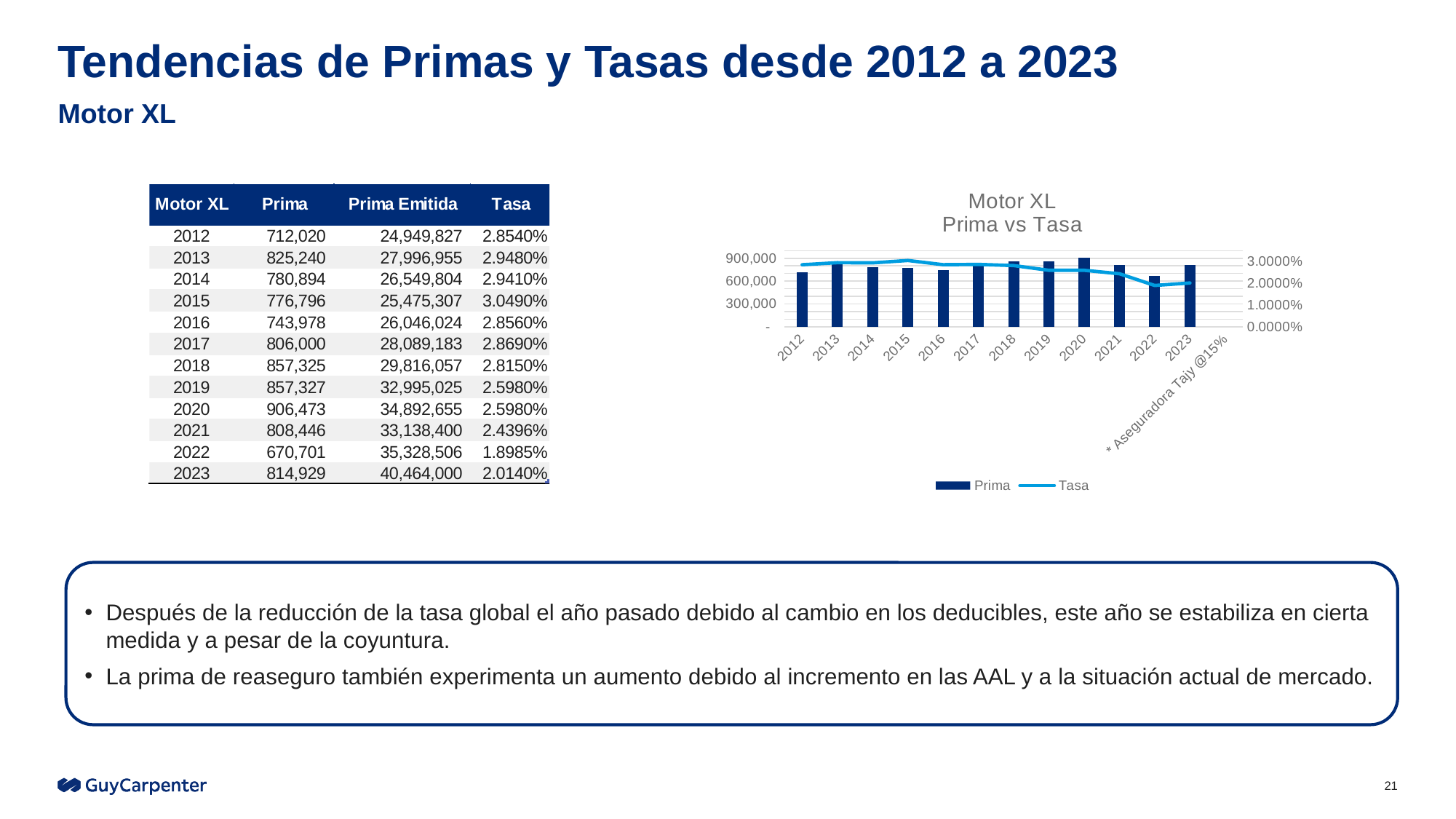
In the "Motor XL Prima vs Tasa" chart, which year has the highest Prima bar? 2020 How many years are plotted on the x axis of the "Motor XL Prima vs Tasa" chart? 12 What is the Prima value for 2020 shown in the Motor XL table? 906,473 Is the Tasa value for 2023 in the "Motor XL Prima vs Tasa" chart greater or less than 1.0000%? greater Which two series are listed in the legend of the "Motor XL Prima vs Tasa" chart? Prima and Tasa How many series does the legend of the "Motor XL Prima vs Tasa" chart list? 2 In the "Motor XL Prima vs Tasa" chart, which year has the lowest Tasa value? 2022 In the "Motor XL Prima vs Tasa" chart, is the Prima bar for 2013 or for 2014 taller? 2013 Is the Prima value for 2012 in the "Motor XL Prima vs Tasa" chart greater or less than 600,000? greater What kind of chart is the "Motor XL Prima vs Tasa" chart? A combined bar and line chart Does the Tasa line in the "Motor XL Prima vs Tasa" chart generally rise or fall from 2012 to 2023? fall In the "Motor XL Prima vs Tasa" chart, which year has the lowest Prima bar? 2022